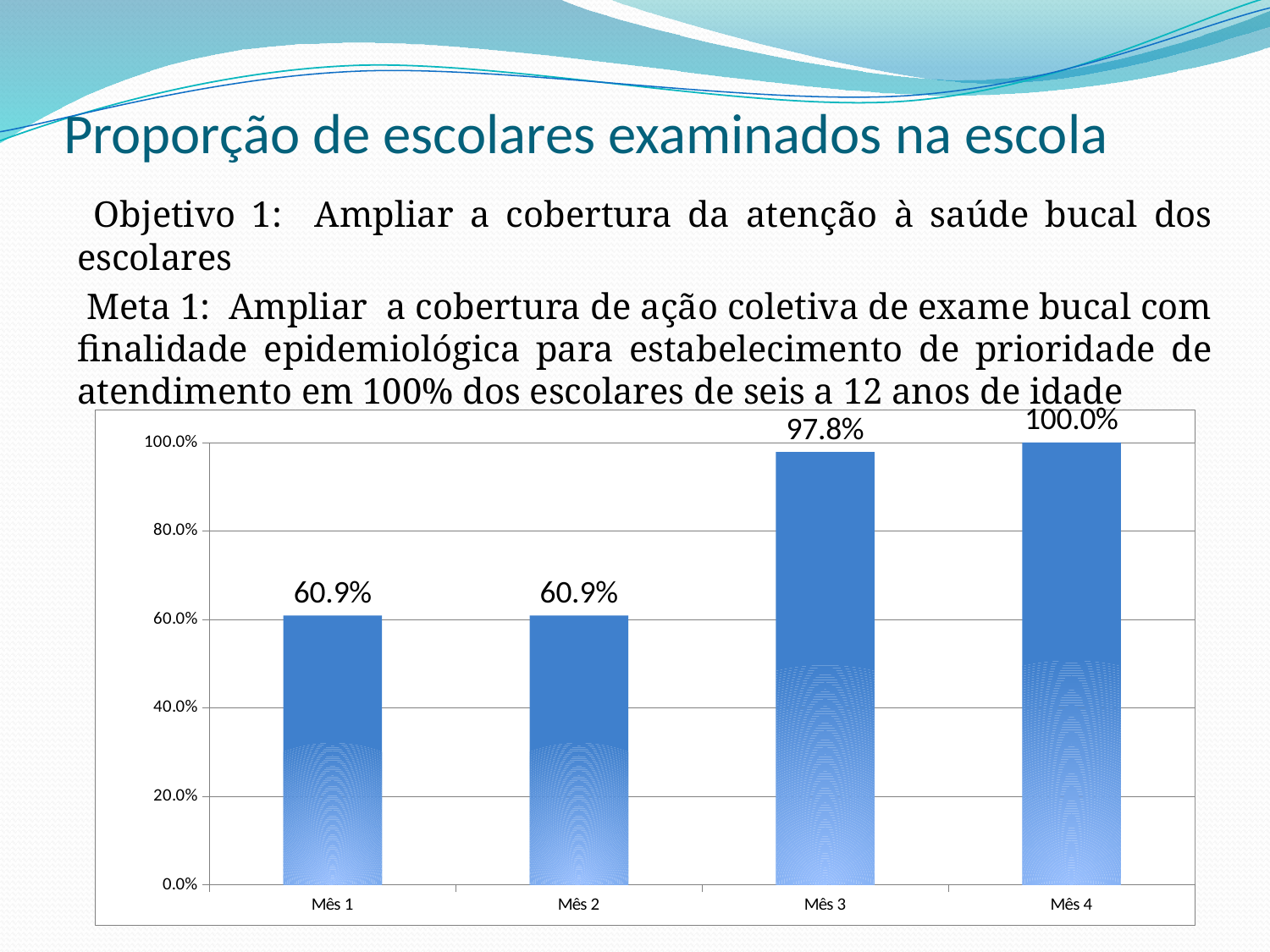
What is the difference between the values for Mês 3 and Mês 2? 36.9% Which month has the highest value? Mês 4 What is the difference between the values for Mês 4 and Mês 3? 2.2% How many months are shown on the x axis? 4 What kind of chart is shown on the slide? bar chart Do Mês 1 and Mês 2 have the same value? Yes Is the value for Mês 2 greater or less than 80.0%? less Do the values rise or fall from Mês 2 to Mês 4? rise Which is larger, the value for Mês 3 or the value for Mês 1? Mês 3 What is the value for Mês 3? 97.8% What is the value for Mês 1? 60.9% What is the value for Mês 4? 100.0%